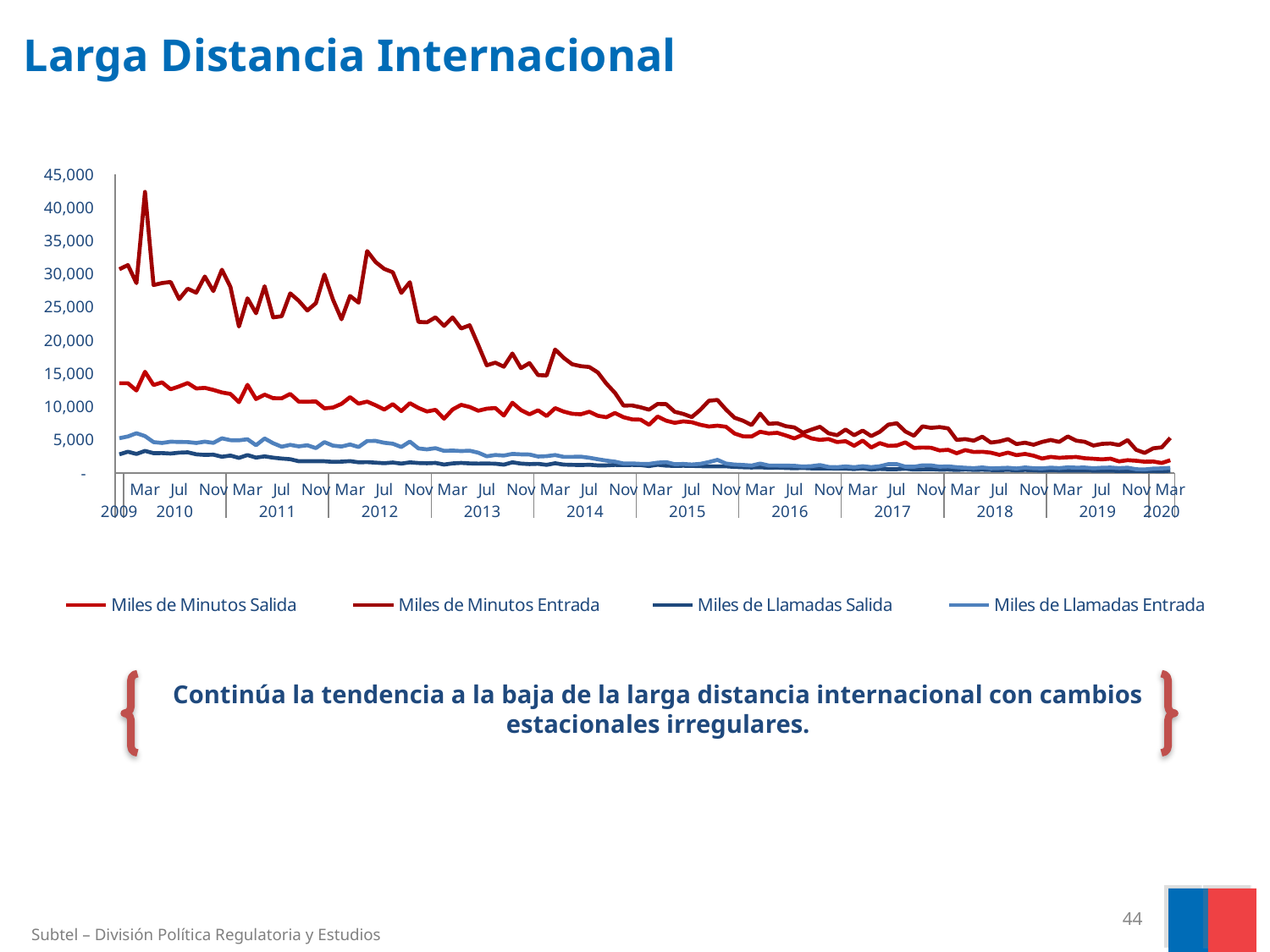
Which series is listed first in the chart legend? Miles de Minutos Salida What is the title of the slide containing the chart? Larga Distancia Internacional Is the value of the Miles de Minutos Salida series in November 2019 greater or less than 5,000? less Do the values of the Miles de Minutos Entrada series rise or fall from 2009 to 2020? fall How many years are labelled on the x axis of the chart? 12 What kind of chart is shown on the slide? line chart Which series has the highest values throughout the chart? Miles de Minutos Entrada How many series does the chart legend list? 4 Is the value of the Miles de Llamadas Salida series in 2018 greater or less than 5,000? less Do the values of the Miles de Minutos Salida series rise or fall from 2009 to 2020? fall